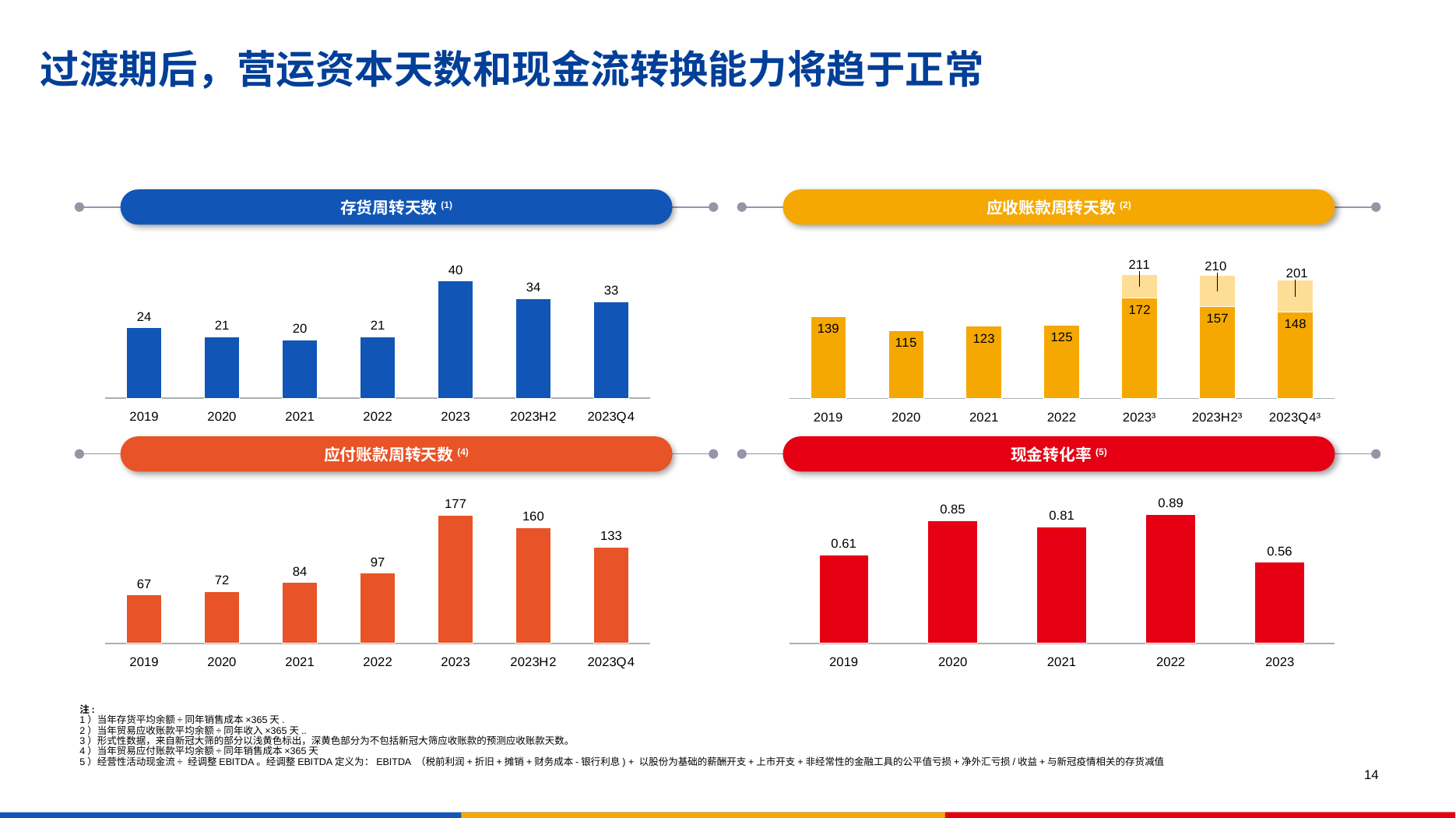
In the 应收账款周转天数 chart, what is the total of the stacked bar for 2023Q4? 201 In the 应收账款周转天数 chart, what is the dark-coloured portion of the 2023H2 bar? 157 In the 存货周转天数 chart, which year has the lowest value? 2021 In the 现金转化率 chart, which year has the lowest value? 2023 In the 应付账款周转天数 chart, do the values rise or fall from 2019 to 2023? rise How many categories are shown on the x axis of the 现金转化率 chart? 5 In the 应付账款周转天数 chart, which category has the highest value? 2023 In the 存货周转天数 chart, what is the value for 2023? 40 In the 存货周转天数 chart, what is the difference between the 2023 value and the 2019 value? 16 In the 现金转化率 chart, is the value for 2020 larger than the value for 2021? Yes, 2020 (0.85) is larger than 2021 (0.81) In the 应付账款周转天数 chart, what is the value for 2022? 97 In the 应收账款周转天数 chart, what is the value for 2020? 115